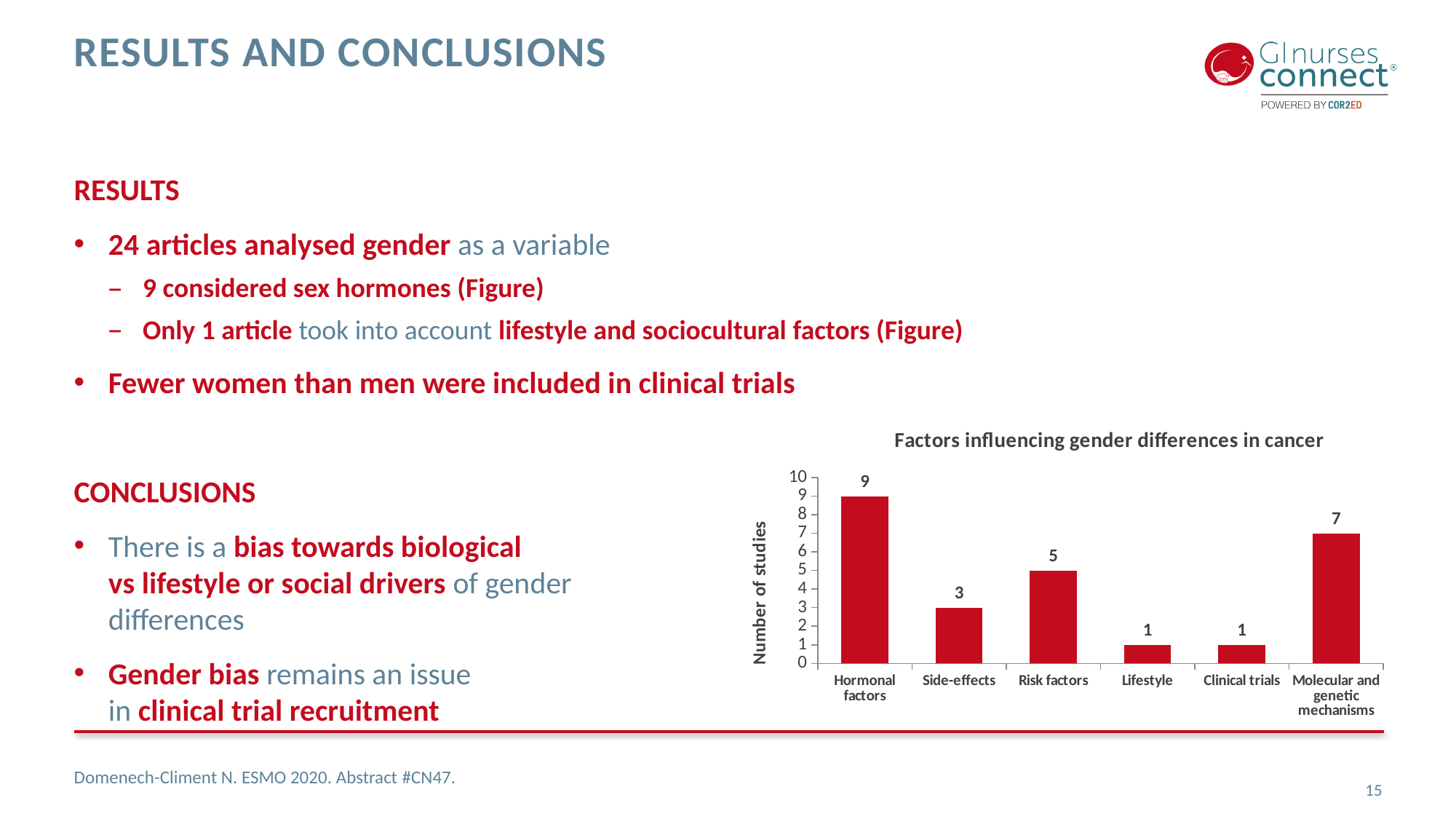
What is the number of studies for Hormonal factors? 9 What is the label of the y axis of the chart? Number of studies Which has more studies, Risk factors or Side-effects? Risk factors What is the number of studies for Side-effects? 3 How many categories are shown on the x axis of the chart? 6 Which category has the highest number of studies? Hormonal factors What is the difference in number of studies between Hormonal factors and Risk factors? 4 What is the difference in number of studies between Molecular and genetic mechanisms and Clinical trials? 6 What is the title of the chart? Factors influencing gender differences in cancer What kind of chart is shown on the slide? Bar chart What is the number of studies for Molecular and genetic mechanisms? 7 Is the value for Molecular and genetic mechanisms greater or less than 5? greater